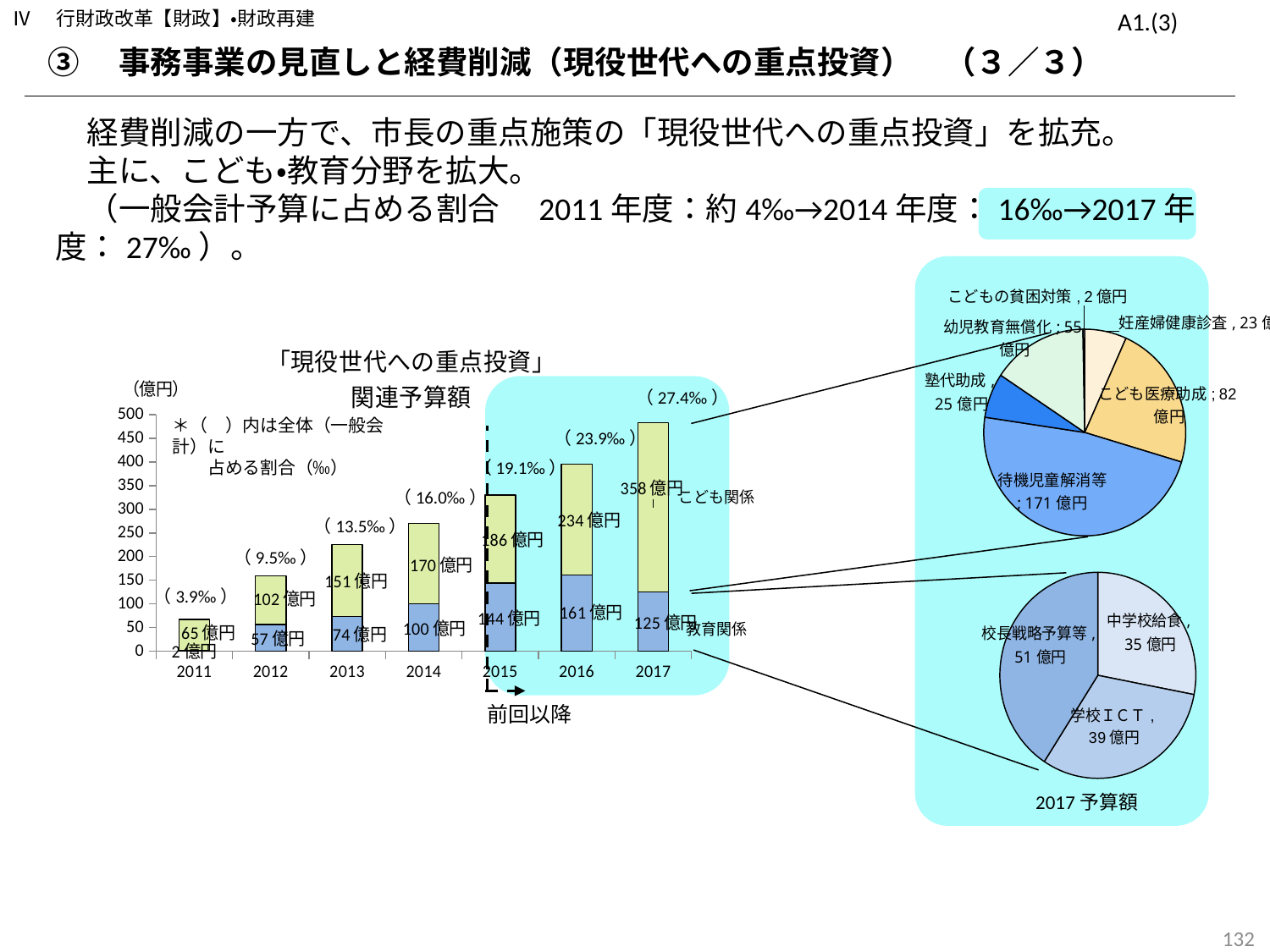
In the upper pie chart on the right (こども関係 2017), what is the value of 待機児童解消等? 171億円 In the bar chart 「現役世代への重点投資」関連予算額, what is the value of こども関係 for 2017? 358億円 How many years are shown on the x axis of the bar chart 「現役世代への重点投資」関連予算額? 7 In the lower pie chart on the right (教育関係 2017), what is the value of 学校ＩＣＴ? 39億円 In the upper pie chart on the right (こども関係 2017), which slice is the smallest? こどもの貧困対策 In the bar chart 「現役世代への重点投資」関連予算額, which is larger for 2015: こども関係 or 教育関係? こども関係 In the bar chart 「現役世代への重点投資」関連予算額, what is the difference between the こども関係 values for 2017 and 2016? 124億円 In the bar chart 「現役世代への重点投資」関連予算額, what is the value of 教育関係 for 2014? 100億円 In the bar chart 「現役世代への重点投資」関連予算額, what share of the general account budget (‰) is shown above the 2016 bar? 23.9‰ What kind of chart is 「現役世代への重点投資」関連予算額? Stacked bar chart In the bar chart 「現役世代への重点投資」関連予算額, what is the total of the stacked bar for 2017? 483億円 In the bar chart 「現役世代への重点投資」関連予算額, which year has the lowest こども関係 value? 2011